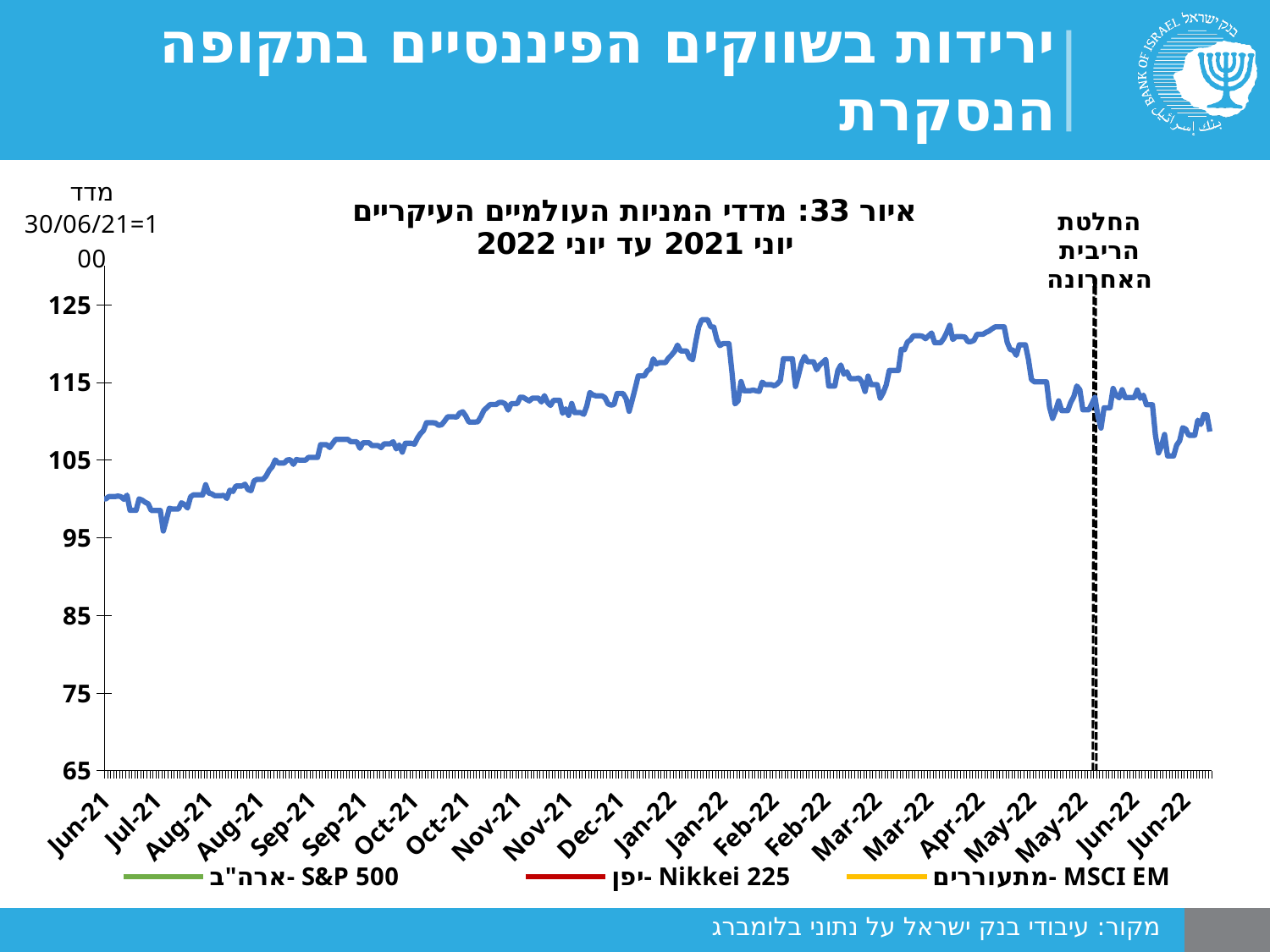
Which three indices are named in the chart legend? S&P 500, Nikkei 225, MSCI EM Is the value of the plotted line at Apr-22 greater or less than 115? greater Is the highest point of the plotted line, around Jan-22, greater or less than 115? greater What kind of chart is shown on the slide? line chart How many series does the chart legend list? 3 What is the lowest value shown on the y axis? 65 What does the label on the dashed vertical line in the chart say? החלטת הריבית האחרונה Is the value of the plotted line at the end of the series (Jun-22) greater or less than 105? greater Does the plotted line generally rise or fall between Jun-21 and Jan-22? rise